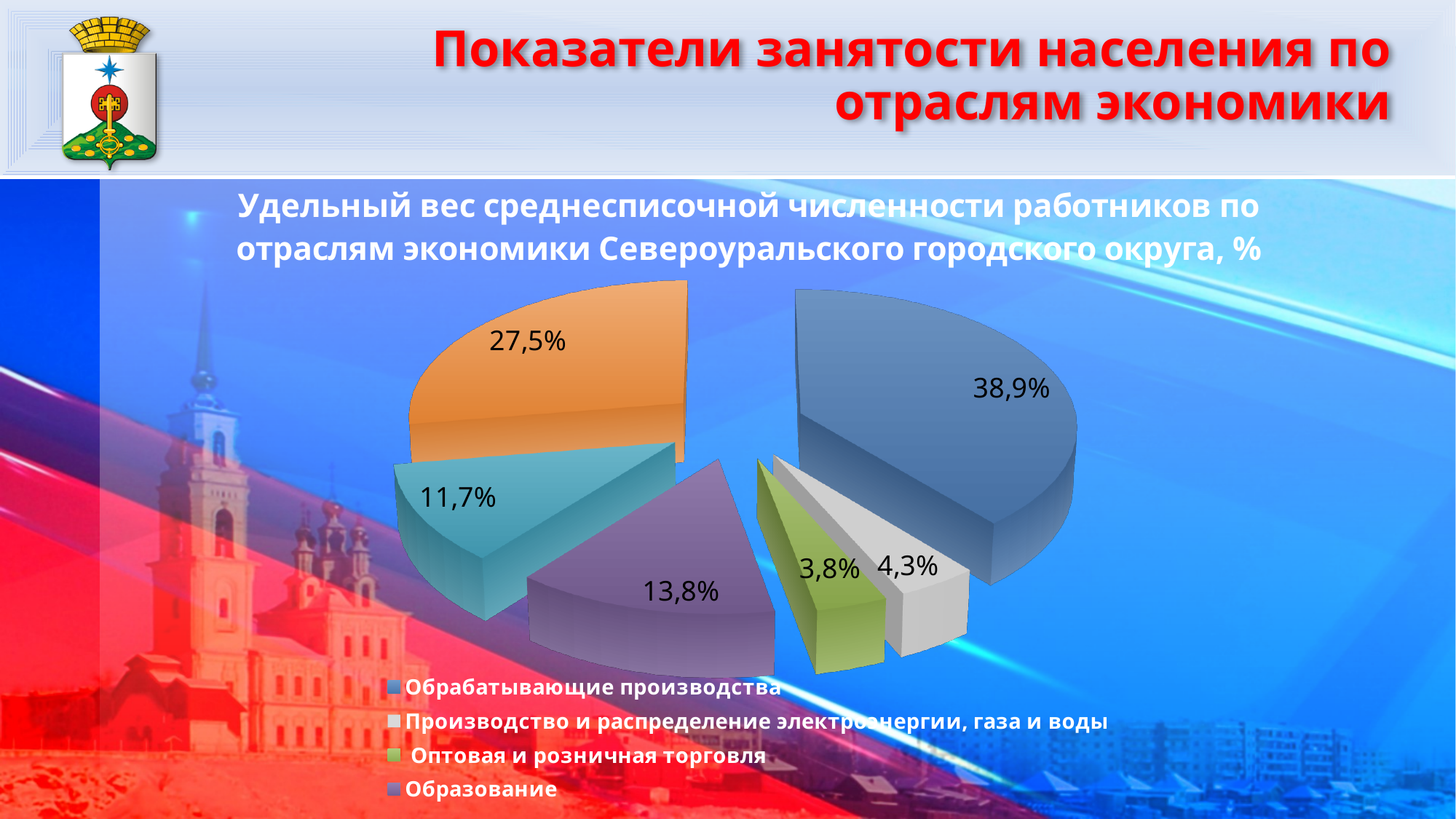
What is the value for Производство и распределение электроэнергии, газа и воды? 4,3% Which is larger: the value for Образование or the value for Производство и распределение электроэнергии, газа и воды? Образование What kind of chart is shown on the slide? Pie chart What is the value for Образование? 13,8% How many slices does the pie chart have? 6 Which category has the smallest slice of the pie? Оптовая и розничная торговля What is the value for Оптовая и розничная торговля? 3,8% Which category has the largest slice of the pie? Обрабатывающие производства What is the difference between the values for Обрабатывающие производства and Образование? 25,1% What share of the pie does Обрабатывающие производства have? 38,9% How many entries does the legend list? 4 What value is shown on the orange slice of the pie? 27,5%